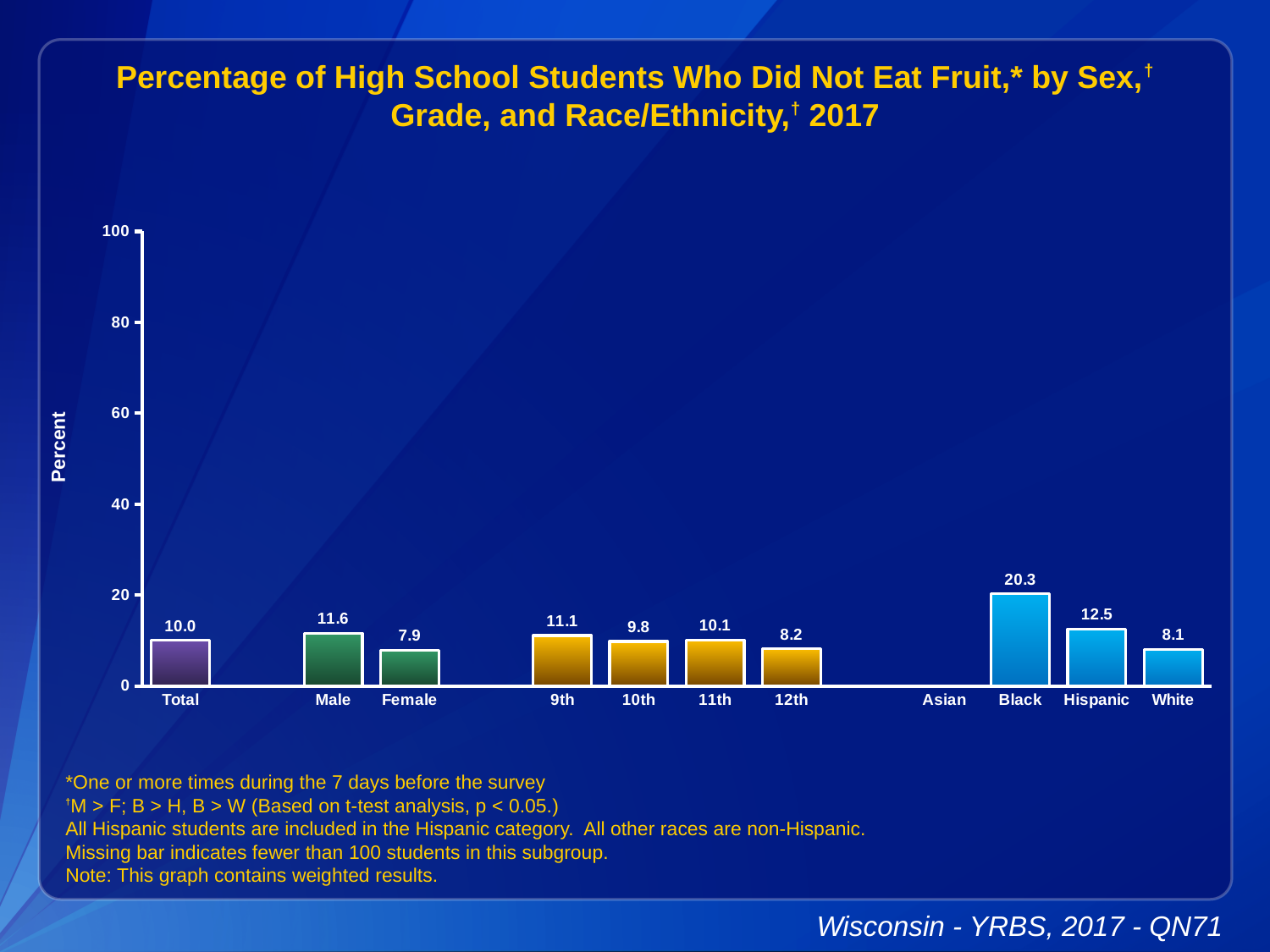
What is the difference between the values for Black and White? 12.2 What is the value for 10th grade? 9.8 Which is larger, the value for 9th grade or the value for 12th grade? 9th Which category has the highest value? Black What is the difference between the values for Male and Female? 3.7 Is the value for Black greater or less than 20? greater What is the value for Female? 7.9 What kind of chart is shown on the slide? bar chart What is the value for Black? 20.3 Which category label on the x axis has no bar plotted? Asian How many bars are plotted on the chart? 10 Which category has the lowest plotted value? Female